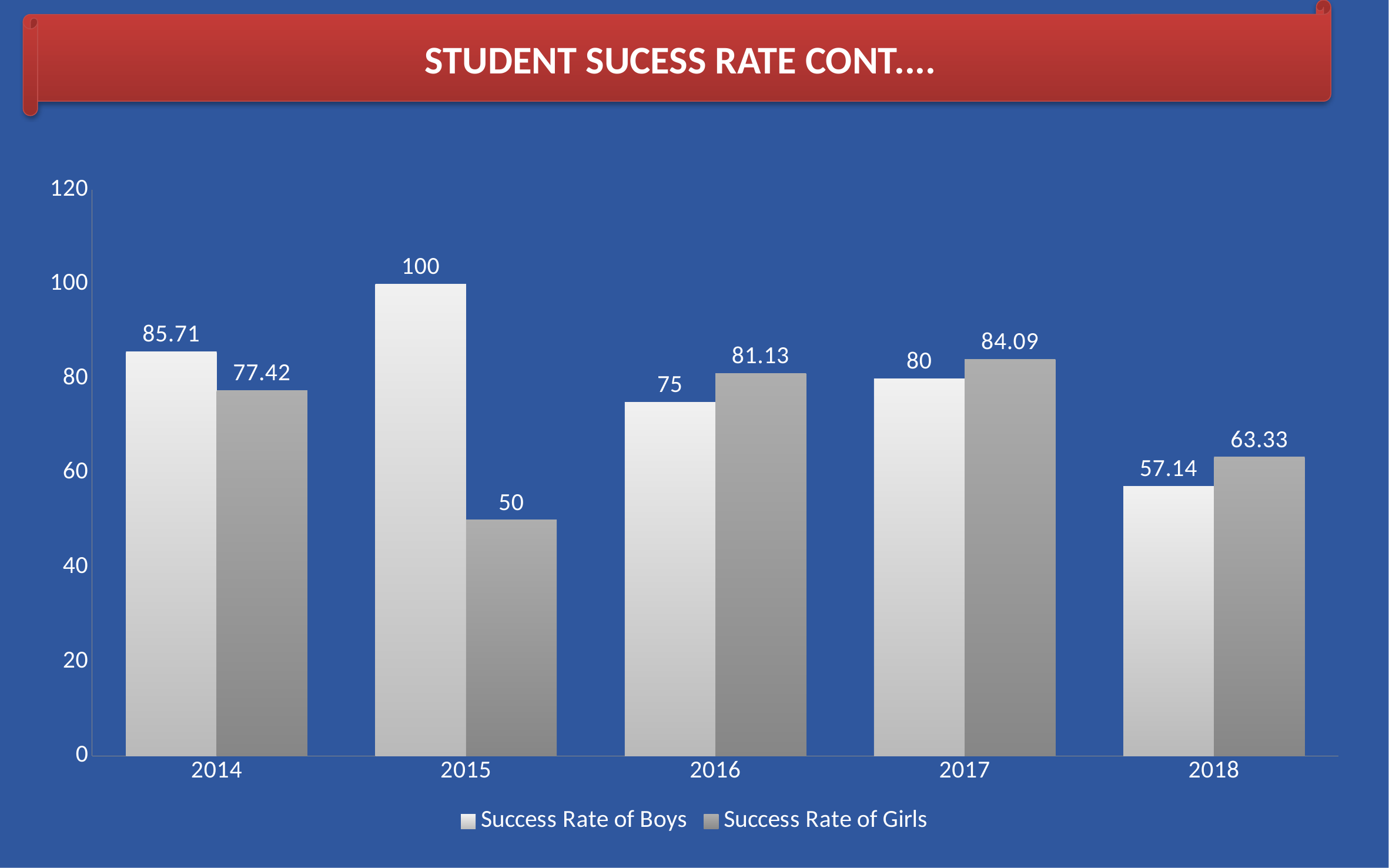
What is the difference between the Success Rate of Boys and the Success Rate of Girls in 2015? 50 In 2016, which is larger: the Success Rate of Boys or the Success Rate of Girls? Success Rate of Girls What is the difference between the Success Rate of Girls in 2017 and in 2018? 20.76 Is the Success Rate of Boys in 2018 greater or less than 60? less What is the Success Rate of Girls in 2014? 77.42 How many years are shown on the x axis? 5 Which year has the highest Success Rate of Boys? 2015 How many series does the legend list? 2 Which year has the lowest Success Rate of Girls? 2015 What is the Success Rate of Boys in 2015? 100 What kind of chart is shown on the slide? bar chart What is the Success Rate of Girls in 2018? 63.33